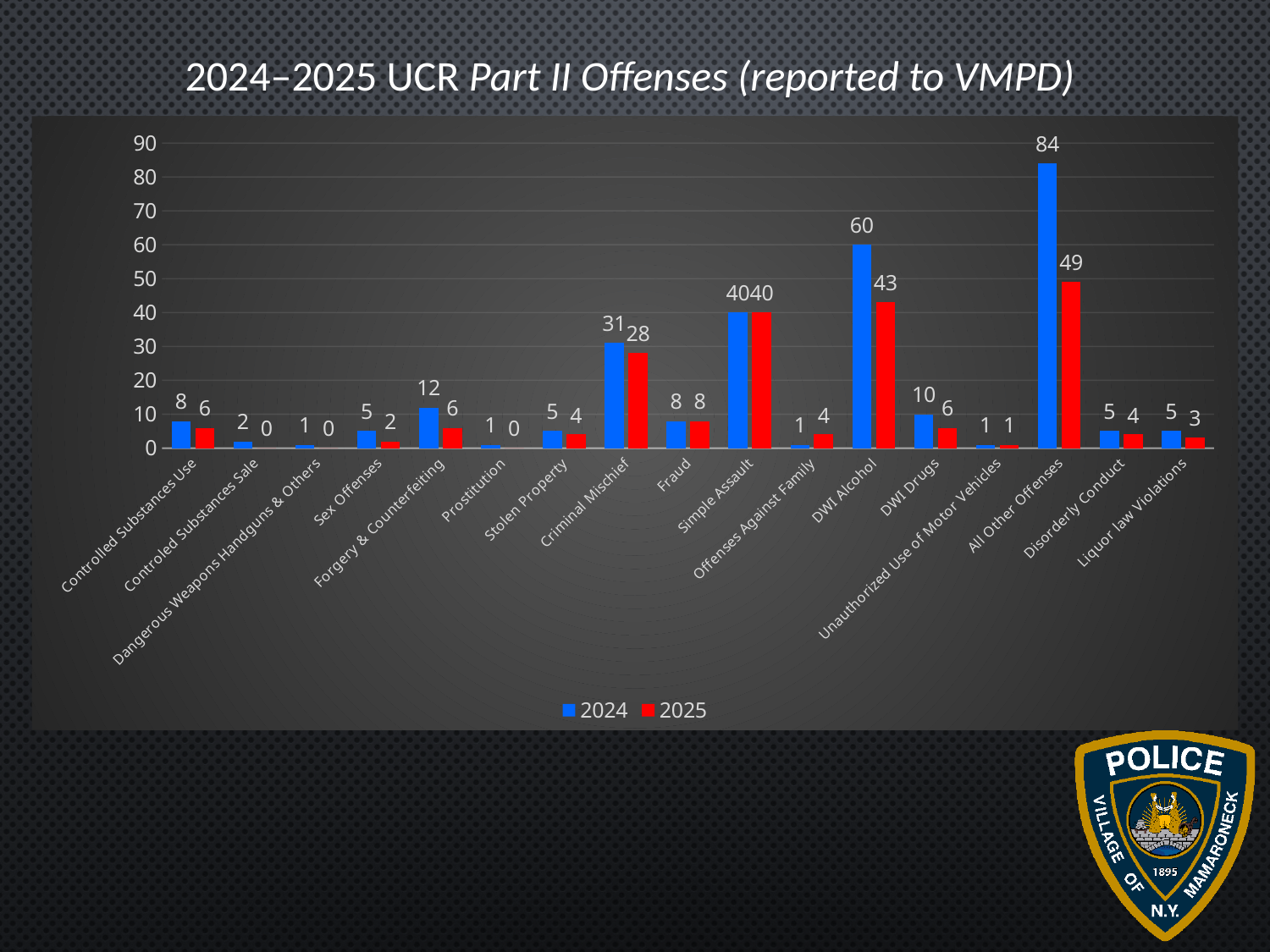
What is the 2025 value for Criminal Mischief? 28 What is the 2025 value for Offenses Against Family? 4 Which category has the highest 2024 value? All Other Offenses What is the difference between the 2024 and 2025 values for DWI Alcohol? 17 Which is larger, the 2024 value for Criminal Mischief or the 2024 value for Simple Assault? Simple Assault What type of chart is shown on the slide? Bar chart What is the 2024 value for DWI Alcohol? 60 What is the difference between the 2024 and 2025 values for All Other Offenses? 35 How many series does the legend list? 2 Which category has the highest 2025 value? All Other Offenses What is the 2024 value for Forgery & Counterfeiting? 12 How many offense categories are shown on the x axis? 17